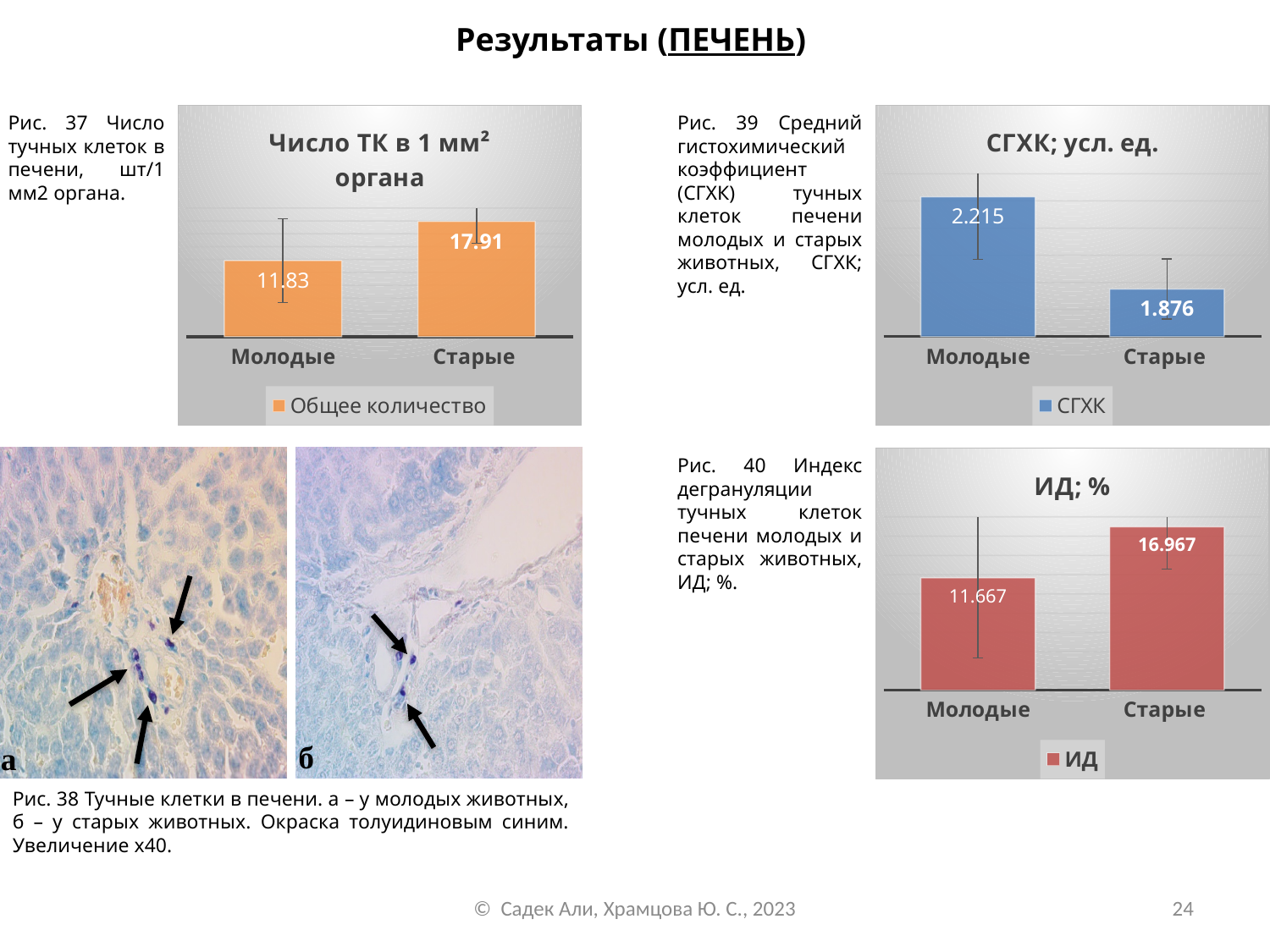
In the chart titled 'СГХК; усл. ед.', what is the difference between the values for Молодые and Старые? 0.339 In the chart titled 'СГХК; усл. ед.', what is the value for Молодые? 2.215 In the chart titled 'СГХК; усл. ед.', which category has the lower value? Старые In the chart titled 'Число ТК в 1 мм² органа', what is the value for Молодые? 11.83 In the chart titled 'Число ТК в 1 мм² органа', what is the difference between the values for Старые and Молодые? 6.08 What type of chart is the chart titled 'ИД; %'? Bar chart In the chart titled 'Число ТК в 1 мм² органа', what is the value for Старые? 17.91 In the chart titled 'СГХК; усл. ед.', what is the value for Старые? 1.876 In the chart titled 'Число ТК в 1 мм² органа', which category has the higher value? Старые In the chart titled 'ИД; %', what is the value for Старые? 16.967 In the chart titled 'ИД; %', what is the difference between the values for Старые and Молодые? 5.300 In the chart titled 'ИД; %', is the value for Молодые or Старые larger? Старые